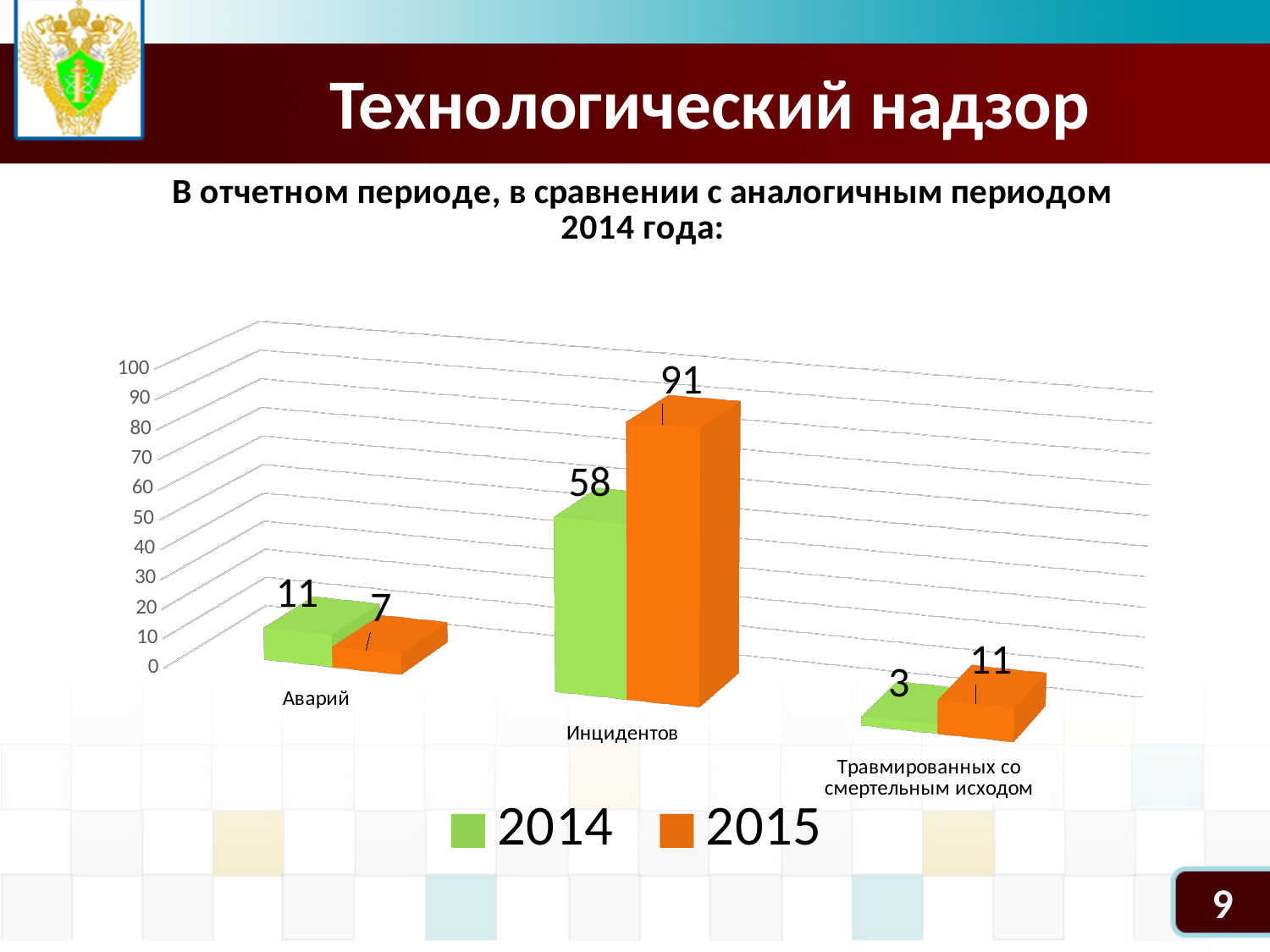
How many categories are shown on the x axis? 3 Which is larger for Аварий: the 2014 value or the 2015 value? 2014 Which category has the lowest value in 2014? Травмированных со смертельным исходом How many series does the legend list? 2 What is the value for Травмированных со смертельным исходом in 2014? 3 Which colour represents the 2015 series in the legend? orange What is the value for Инцидентов in 2015? 91 Which category has the highest value in 2015? Инцидентов Is the 2015 value for Инцидентов greater or less than 80? greater What is the difference between the 2015 and 2014 values for Инцидентов? 33 What kind of chart is shown on the slide? bar chart What is the value for Аварий in 2014? 11